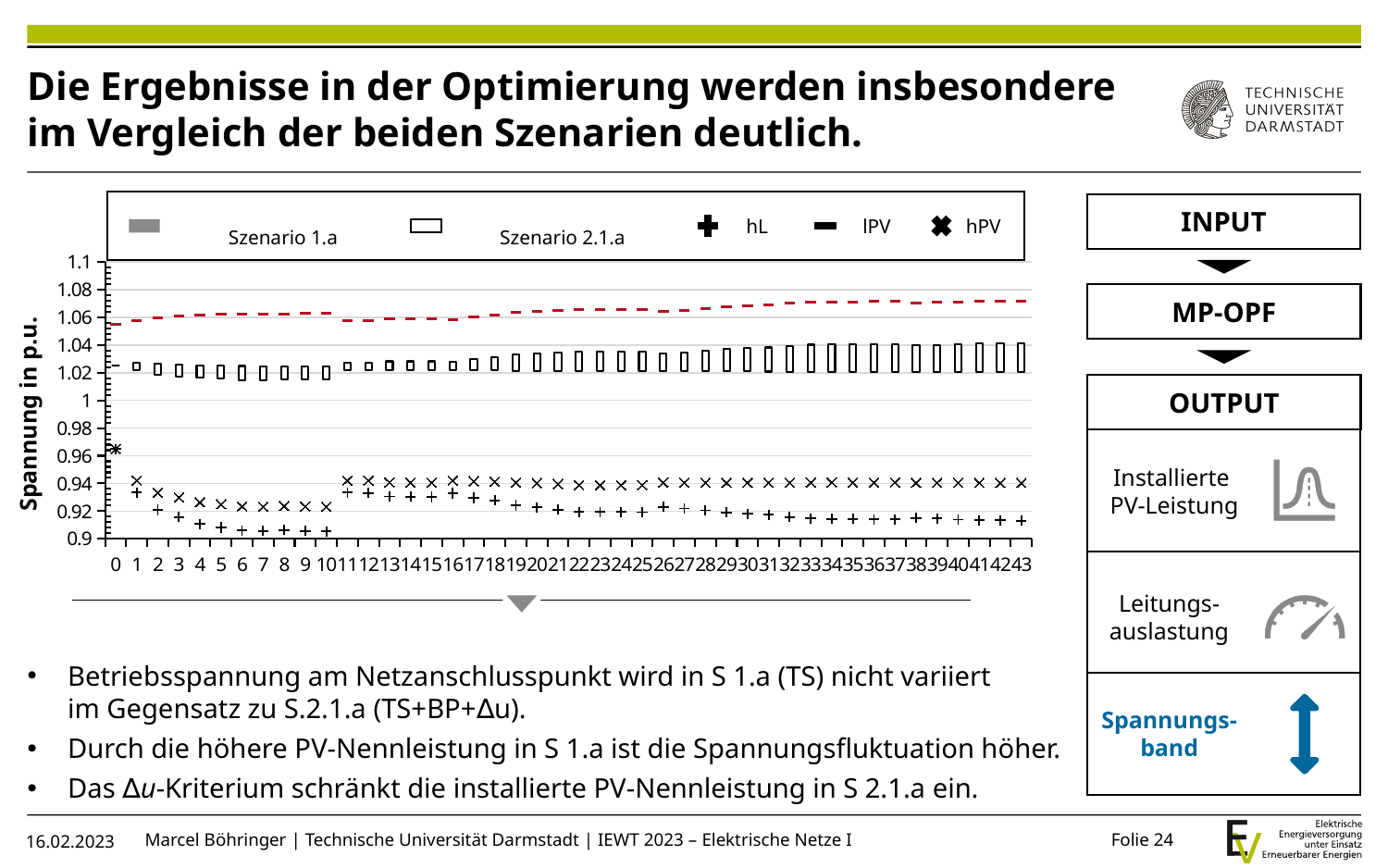
Does the lPV series generally rise or fall from x = 0 to x = 43? rise Does the hL series rise or fall between x = 1 and x = 10? fall What is the highest value shown on the vertical axis of the chart? 1.1 How many series does the chart legend list? 5 What are the two scenario names shown in the chart legend? Szenario 1.a and Szenario 2.1.a What is the label of the vertical axis of the chart? Spannung in p.u. How many points are labelled along the x axis of the chart (from 0 to 43)? 44 Is the hL value at x = 43 greater or less than 0.94? less What is the lowest value shown on the vertical axis of the chart? 0.9 Is the lPV value at x = 43 greater or less than 1.06? greater Is the hL value at x = 10 greater or less than 0.92? less At x = 43, which series has the higher value, lPV or hL? lPV